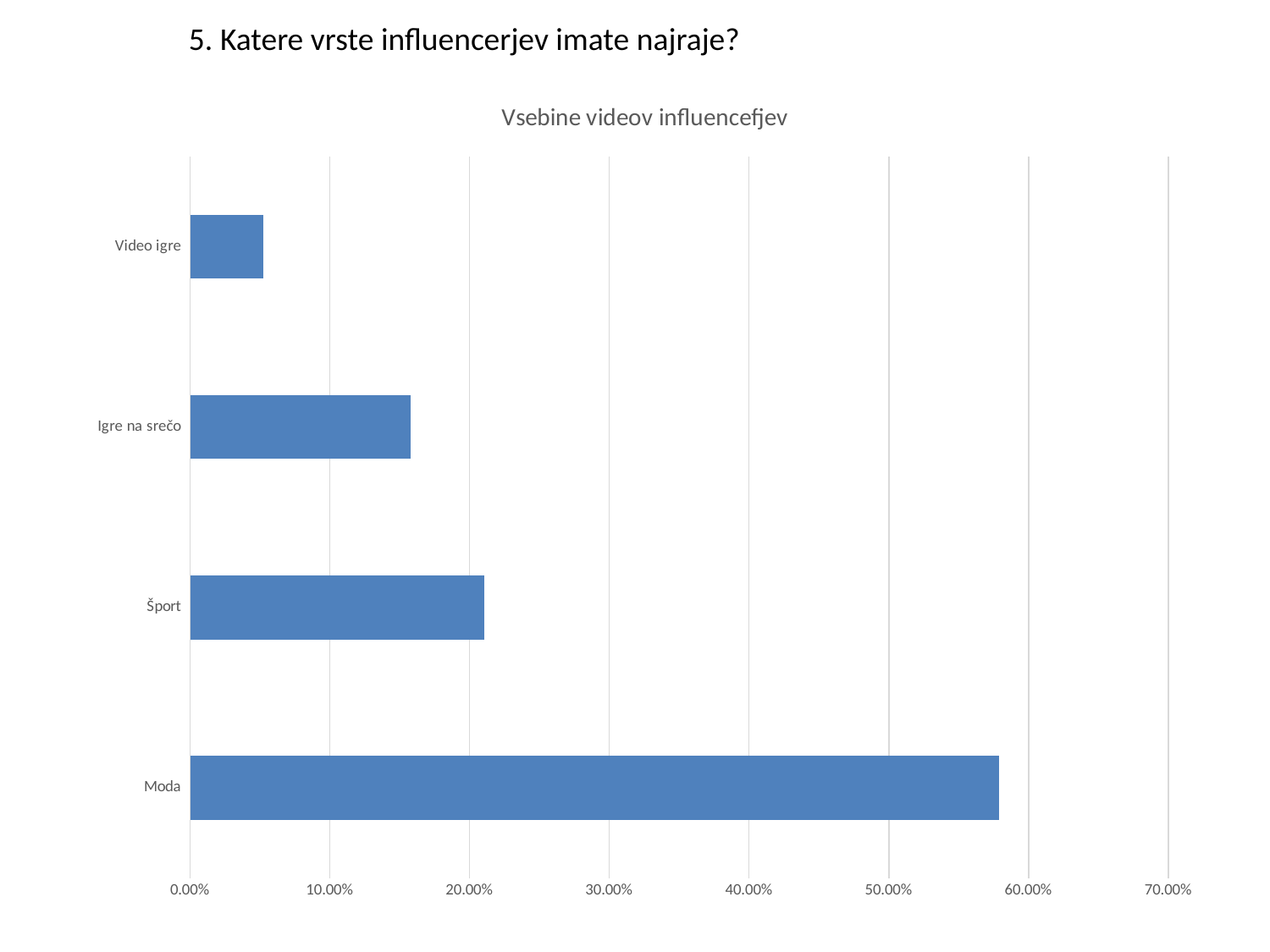
Is the value for Šport greater or less than 30.00%? less What kind of chart is shown on the slide? bar chart Is the value for Moda greater or less than 50.00%? greater Which category has the highest value? Moda How many categories are shown in the chart? 4 Is the value for Moda greater or less than 60.00%? less Which category has the lowest value? Video igre Which has a larger value, Šport or Igre na srečo? Šport What is the title of the chart? Vsebine videov influencefjev Which has a larger value, Moda or Šport? Moda